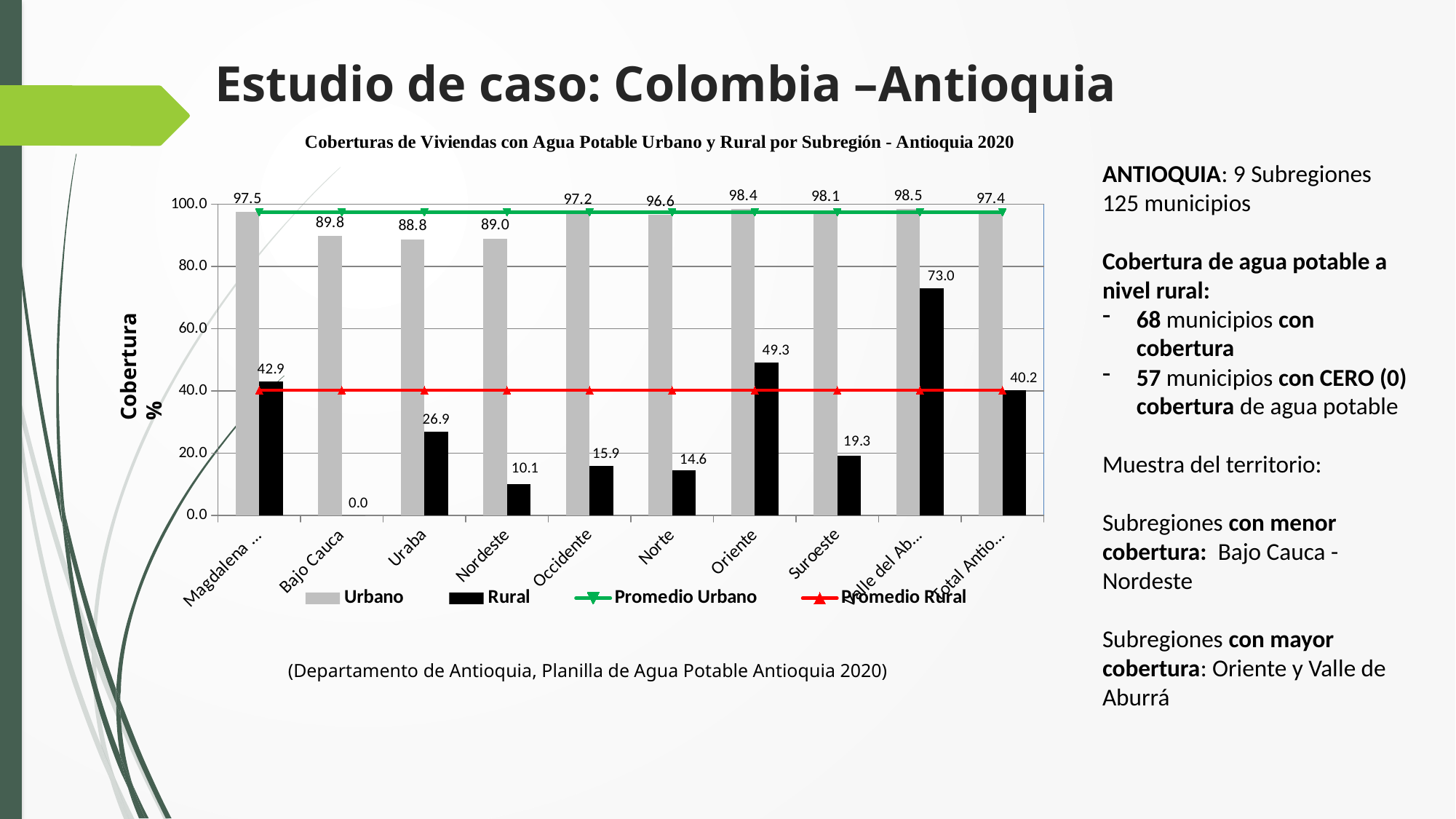
What colour are the Rural bars? black How many series does the legend list? 4 Which has a larger Rural value, Uraba or Suroeste? Uraba What is the Urbano value for Suroeste? 98.1 Which subregion has the lowest Rural value? Bajo Cauca What is the Urbano value for Bajo Cauca? 89.8 What is the Rural value for Oriente? 49.3 Is the Rural value for Occidente greater or less than 20.0? less What is the difference between the Rural values for Oriente and Suroeste? 30.0 What is the difference between the Urbano and Rural values for Norte? 82.0 What is the Rural value for Nordeste? 10.1 How many categories are shown on the x axis? 10